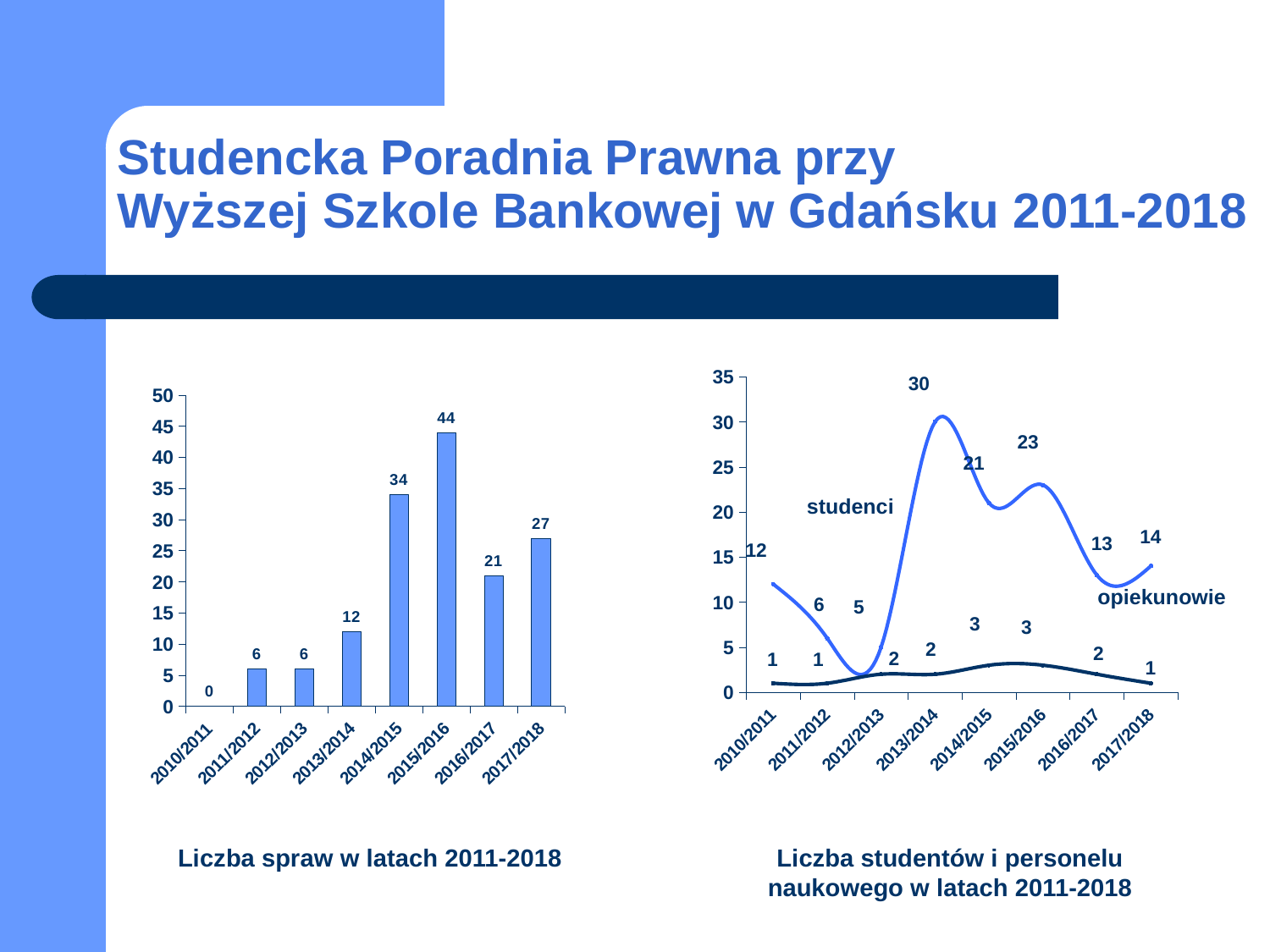
In the chart titled 'Liczba spraw w latach 2011-2018', which year has the lowest value? 2010/2011 In the chart titled 'Liczba studentów i personelu naukowego w latach 2011-2018', which is larger: the studenci value for 2015/2016 or for 2016/2017? 2015/2016 What kind of chart is the one titled 'Liczba spraw w latach 2011-2018'? bar chart In the chart titled 'Liczba spraw w latach 2011-2018', what is the difference between the values for 2015/2016 and 2014/2015? 10 In the chart titled 'Liczba studentów i personelu naukowego w latach 2011-2018', what is the difference between the studenci and opiekunowie values in 2017/2018? 13 In the chart titled 'Liczba studentów i personelu naukowego w latach 2011-2018', which year has the highest value for studenci? 2013/2014 What kind of chart is the one titled 'Liczba studentów i personelu naukowego w latach 2011-2018'? line chart In the chart titled 'Liczba studentów i personelu naukowego w latach 2011-2018', what is the value for opiekunowie in 2014/2015? 3 In the chart titled 'Liczba studentów i personelu naukowego w latach 2011-2018', what is the value for studenci in 2013/2014? 30 In the chart titled 'Liczba spraw w latach 2011-2018', what is the value for 2015/2016? 44 In the chart titled 'Liczba spraw w latach 2011-2018', how many years are shown on the x axis? 8 In the chart titled 'Liczba spraw w latach 2011-2018', which year has the highest value? 2015/2016